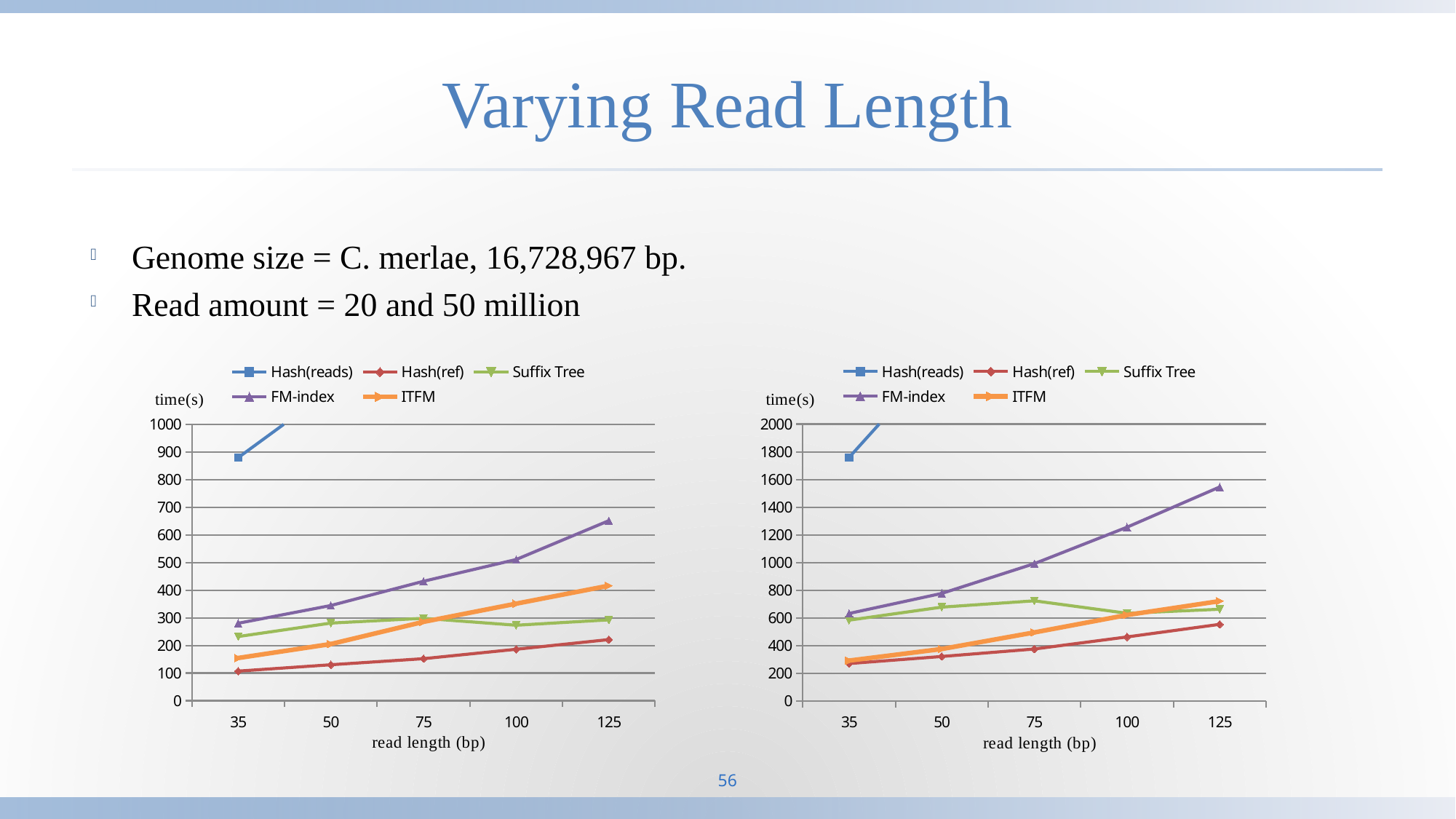
What is the label of the x axis on the right chart? read length (bp) In the right chart, which series has the lowest value at read length 35? Hash(ref) In the right chart, is the FM-index value at read length 125 greater or less than 1400? greater In the left chart, which series has the highest value at read length 125 among the lines that stay within the plot area? FM-index In the right chart, at read length 125, which is larger: the ITFM value or the Hash(ref) value? ITFM How many read length values are shown on the x axis of the left chart? 5 In the right chart, is the Hash(reads) value at read length 35 greater or less than 1600? greater What kind of chart is the left chart? line chart In the left chart, at read length 50, which is larger: the Suffix Tree value or the ITFM value? Suffix Tree How many series does the legend of the right chart list? 5 In the left chart, does the FM-index line rise or fall as read length increases? rises In the left chart, is the Hash(ref) value at read length 125 greater or less than 300? less